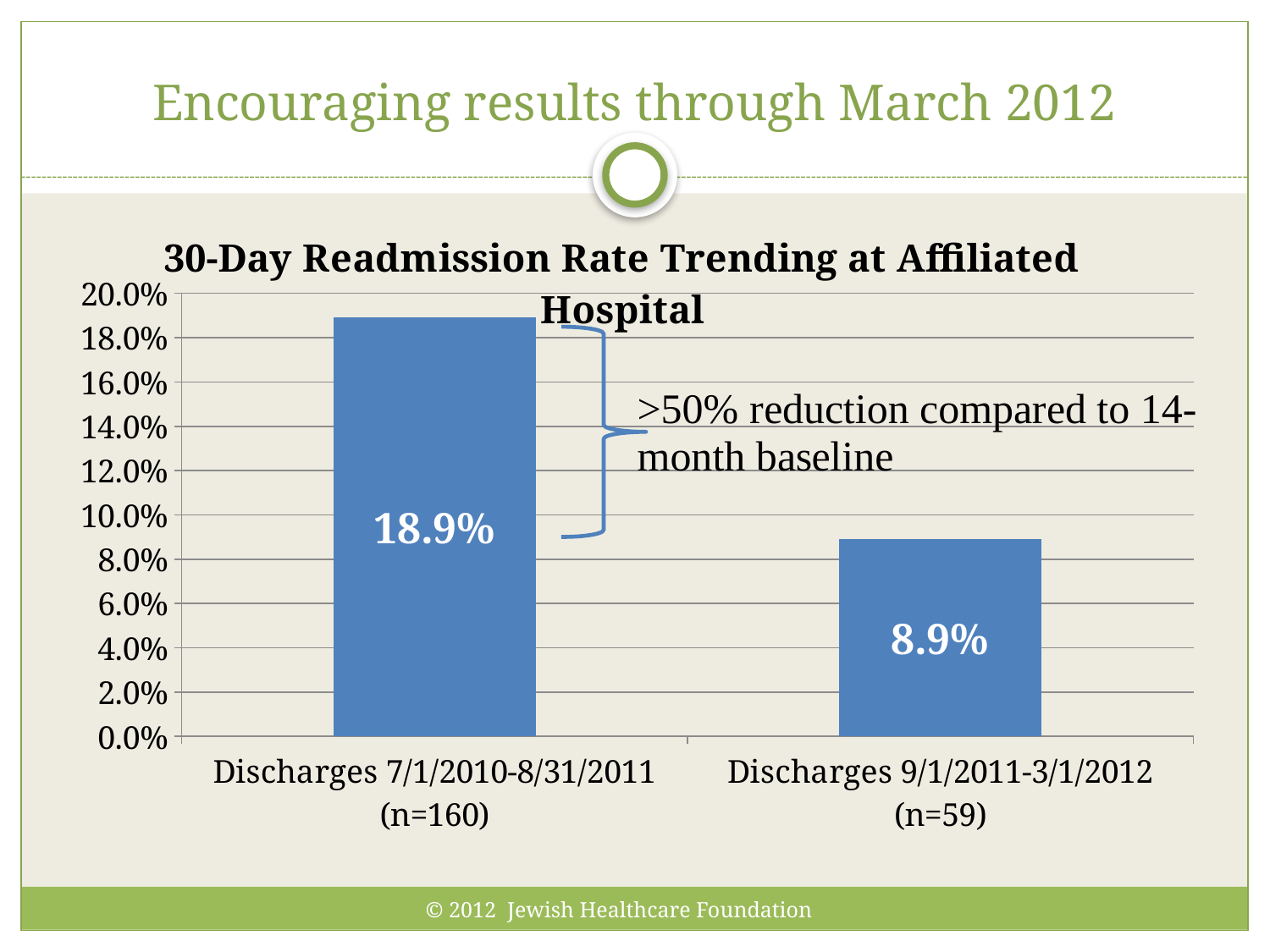
What is the maximum value shown on the chart's vertical axis? 20.0% Does the readmission rate rise or fall from the first discharge period to the second? Fall Is the readmission rate for Discharges 7/1/2010-8/31/2011 greater or less than 18.0%? greater Which discharge period has the lower readmission rate? Discharges 9/1/2011-3/1/2012 (n=59) Is the readmission rate for Discharges 9/1/2011-3/1/2012 greater or less than 10.0%? less What type of chart is shown on the slide? Bar chart What is the title of the chart? 30-Day Readmission Rate Trending at Affiliated Hospital What is the difference in readmission rate between the 7/1/2010-8/31/2011 period and the 9/1/2011-3/1/2012 period? 10.0% How many discharge periods are plotted in the chart? 2 Which discharge period has the higher readmission rate? Discharges 7/1/2010-8/31/2011 (n=160) What is the 30-day readmission rate for Discharges 7/1/2010-8/31/2011 (n=160)? 18.9% What is the 30-day readmission rate for Discharges 9/1/2011-3/1/2012 (n=59)? 8.9%